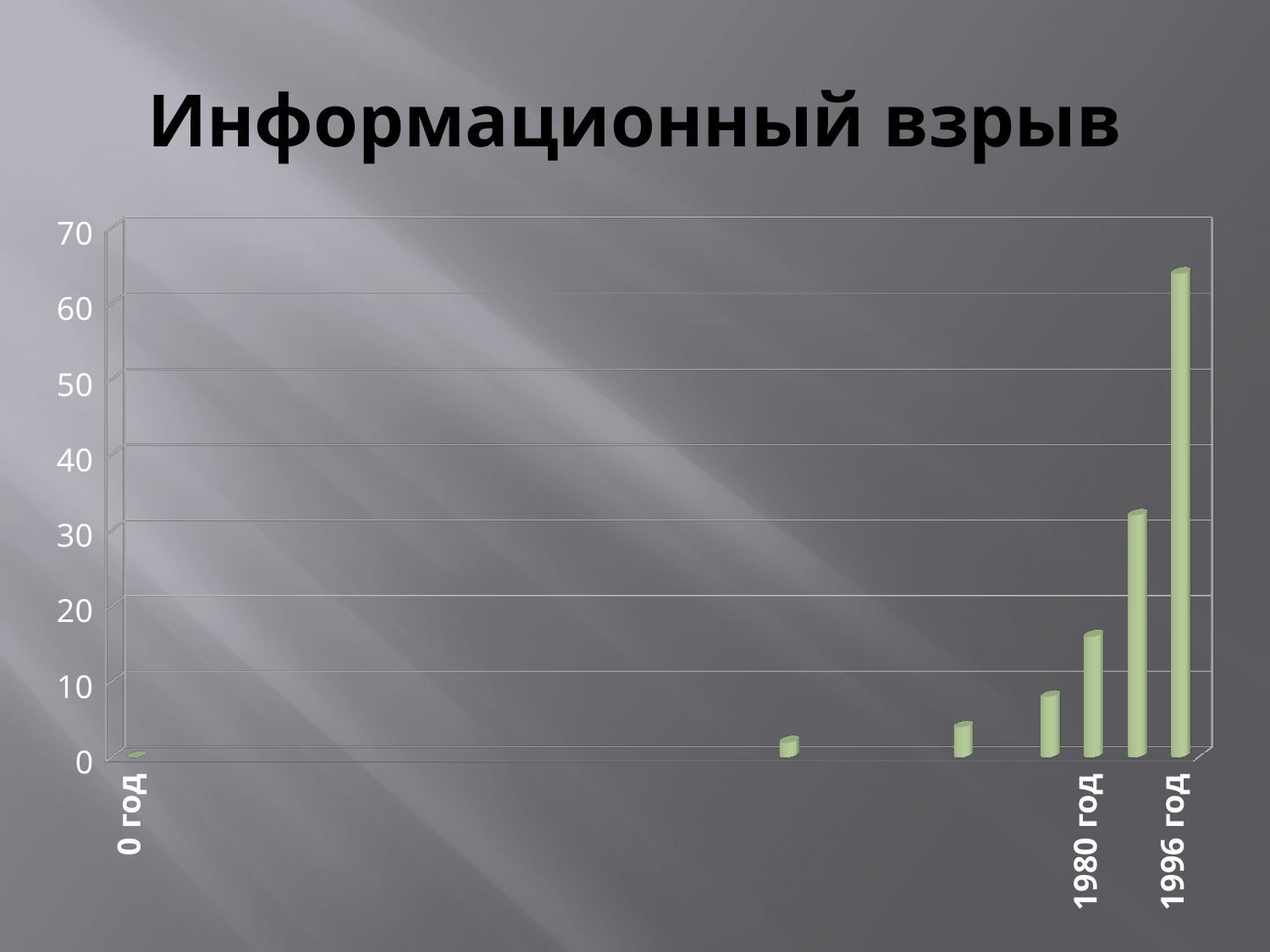
Which category has the lowest bar? 0 год Which is larger, the value for 1980 год or the value for 1996 год? 1996 год Is the value for 1980 год greater or less than 10? greater Do the bar values rise or fall from left to right along the x axis? rise What is the title of the chart? Информационный взрыв Is the value for 1996 год greater or less than 50? greater What kind of chart is shown on the slide? bar chart Which category has the highest bar? 1996 год Is the value for 1996 год greater or less than 60? greater How many bars are plotted in the chart? 7